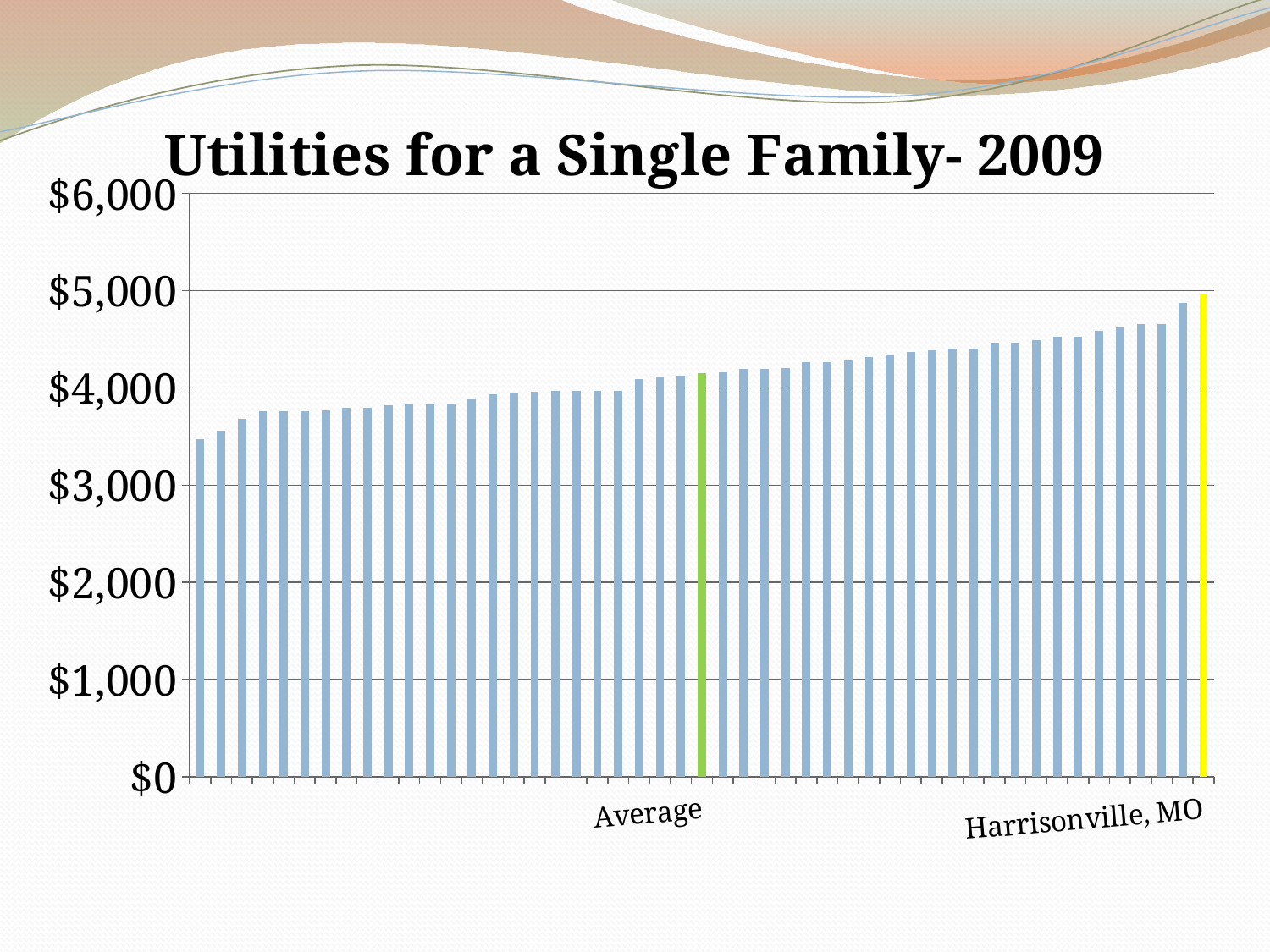
Is the value of the leftmost bar greater or less than $4,000? less Is the value of the leftmost bar greater or less than $3,000? greater What is the title of the chart? Utilities for a Single Family- 2009 What kind of chart is shown on the slide? Bar chart Which is larger, the value for Harrisonville, MO or the value for Average? Harrisonville, MO Is the value for Harrisonville, MO greater or less than $4,000? greater What colour is the bar for Harrisonville, MO? Yellow Which labeled category has the highest value in the chart? Harrisonville, MO Do the bar values rise or fall from left to right along the x axis? Rise